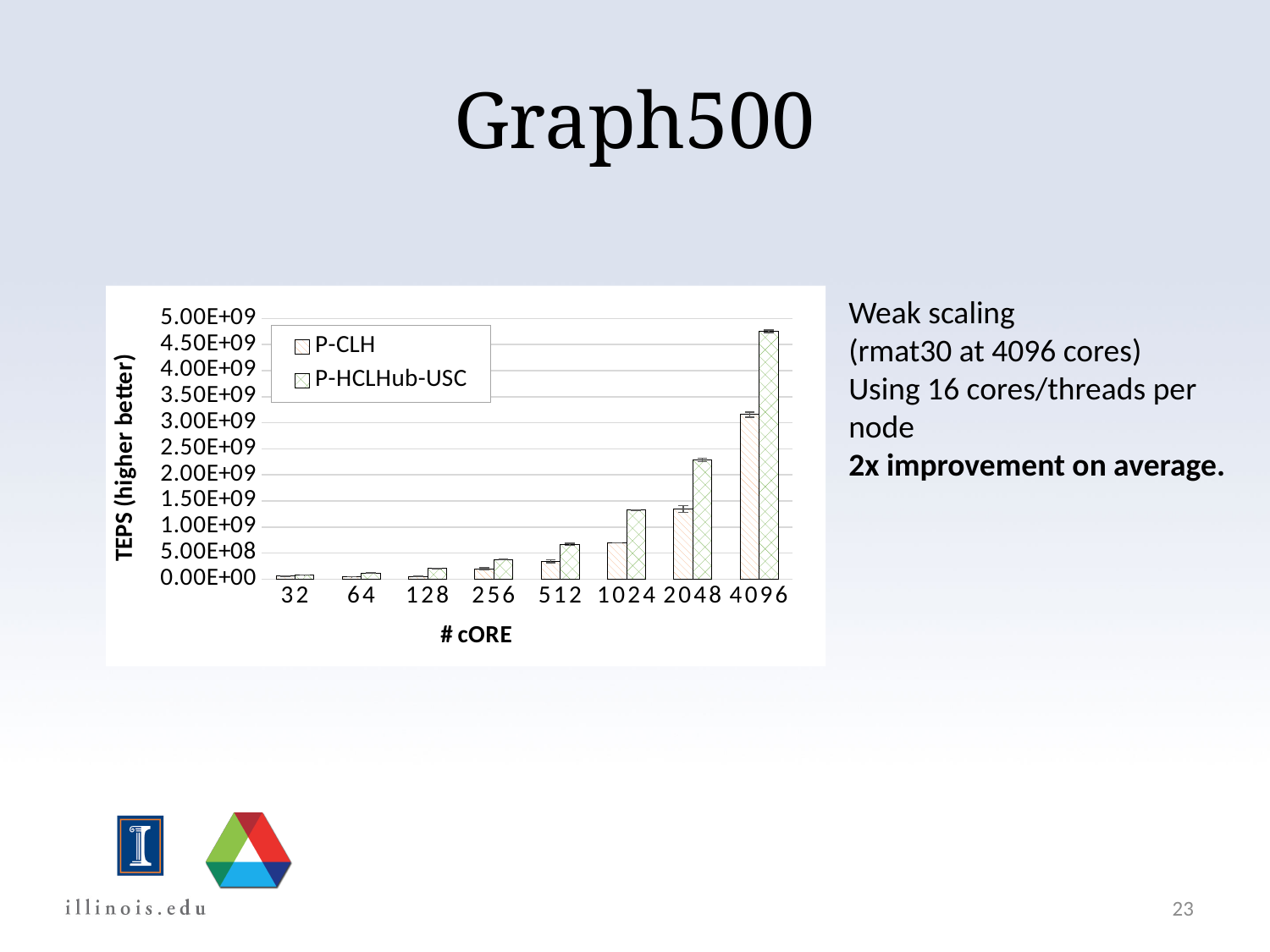
What kind of chart is shown on the slide? bar chart Is the P-CLH value at 2048 cores greater or less than 1.50E+09? less Is the P-HCLHub-USC value at 4096 cores greater or less than 4.50E+09? greater How many series does the chart legend list? 2 At which core count does P-HCLHub-USC reach its highest value? 4096 Which series is listed second in the legend? P-HCLHub-USC Is the P-HCLHub-USC value at 2048 cores greater or less than 2.00E+09? greater At 4096 cores, which series has the larger value, P-CLH or P-HCLHub-USC? P-HCLHub-USC How many core-count categories are shown on the x axis? 8 What is the title of the y axis? TEPS (higher better) Do the P-HCLHub-USC values rise or fall as the number of cores increases? rise